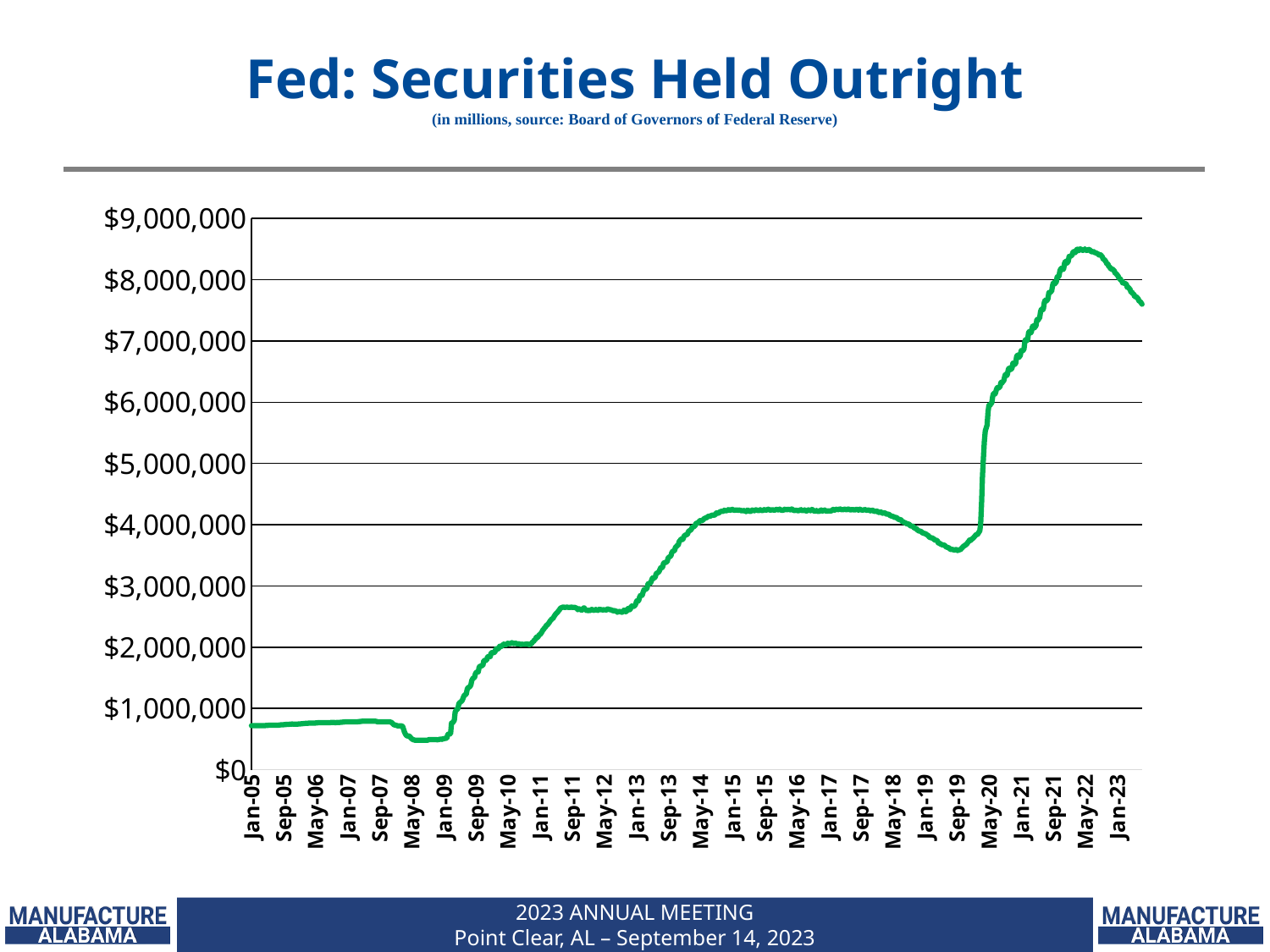
Does the line rise or fall between May-22 and Jan-23? fall Is the value at Jan-13 greater or less than $3,000,000? less According to the subtitle, what is the source of the data? Board of Governors of Federal Reserve Is the value at Sep-19 greater or less than $4,000,000? less Is the value at Jan-15 greater or less than $4,000,000? greater What kind of chart is shown on the slide? line chart Around which x-axis label does the line reach its highest point? May-22 What is the title of the chart? Fed: Securities Held Outright Overall, does the line rise or fall from Jan-05 to Jan-23? rise